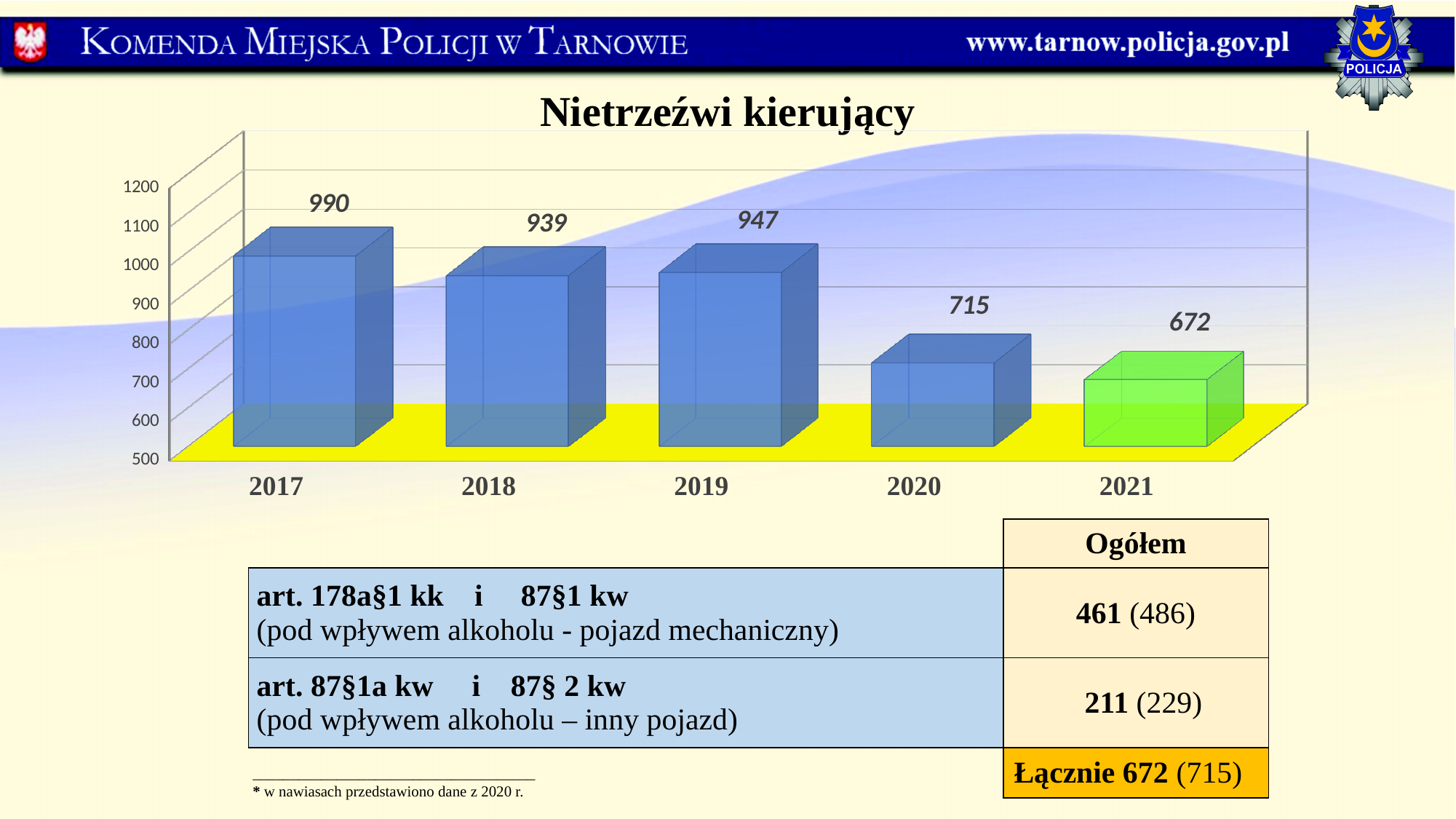
What is the value for 2017? 990 How many years are shown on the chart? 5 What kind of chart is shown on the slide? bar chart Is the value for 2019 greater or less than 900? greater Which year has the highest value? 2017 What is the value for 2021? 672 Which is larger, the value for 2018 or the value for 2019? 2019 What is the title of the chart? Nietrzeźwi kierujący What is the difference between the values for 2017 and 2019? 43 Which year has the lowest value? 2021 What is the difference between the values for 2020 and 2021? 43 What is the value for 2020? 715